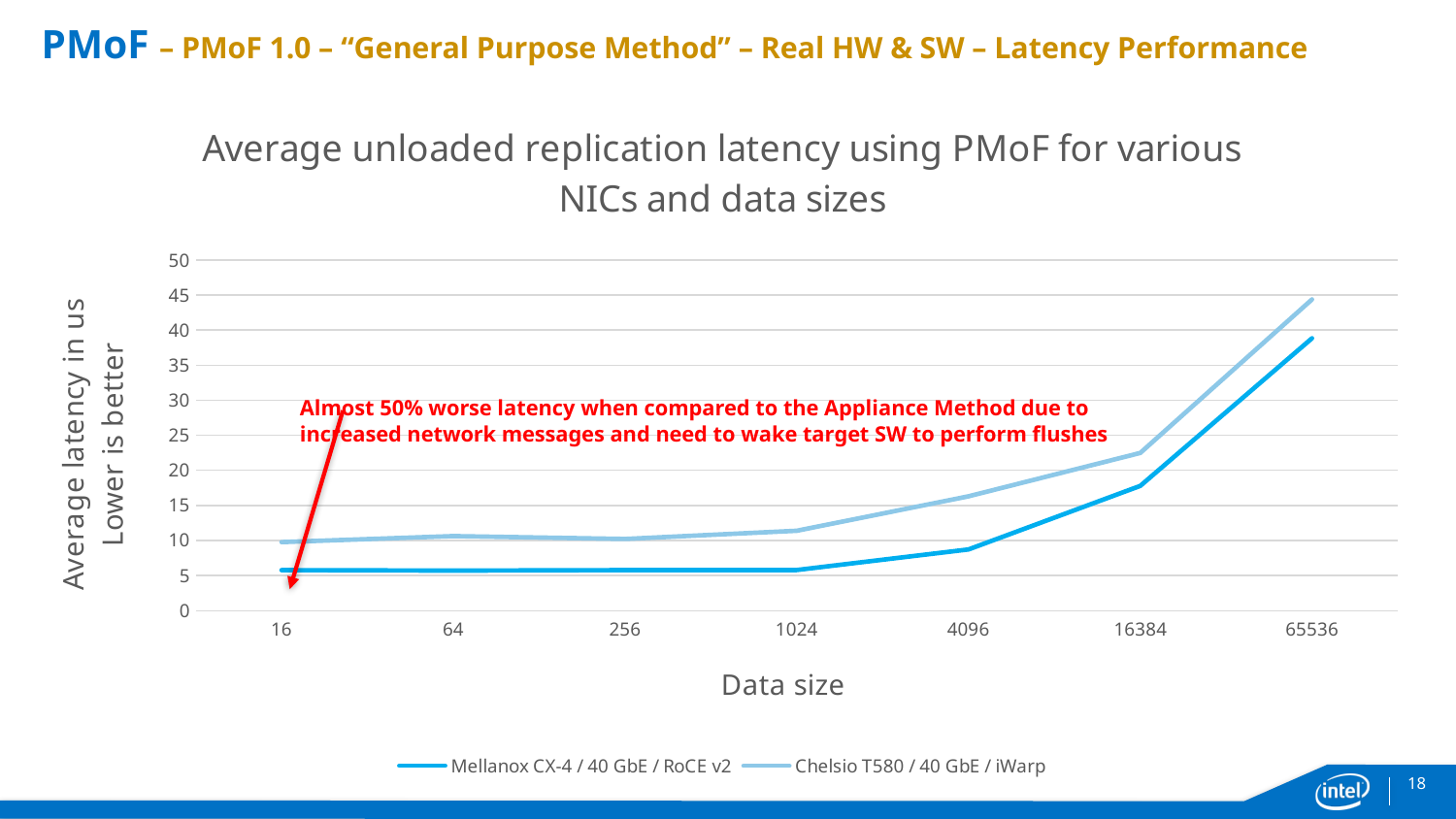
Is the value for Mellanox CX-4 / 40 GbE / RoCE v2 at data size 16384 greater or less than 20? less Is the value for Chelsio T580 / 40 GbE / iWarp at data size 16 greater or less than 15? less How many data sizes are plotted along the x axis? 7 Is the value for Chelsio T580 / 40 GbE / iWarp at data size 65536 greater or less than 40? greater What is the label of the y axis? Average latency in us Lower is better For Mellanox CX-4 / 40 GbE / RoCE v2, at which data size is the latency highest? 65536 What kind of chart is shown on the slide? Line chart Does the latency for Chelsio T580 / 40 GbE / iWarp generally rise or fall as data size increases? rise How many series does the legend list? 2 At data size 1024, which series has the higher latency? Chelsio T580 / 40 GbE / iWarp